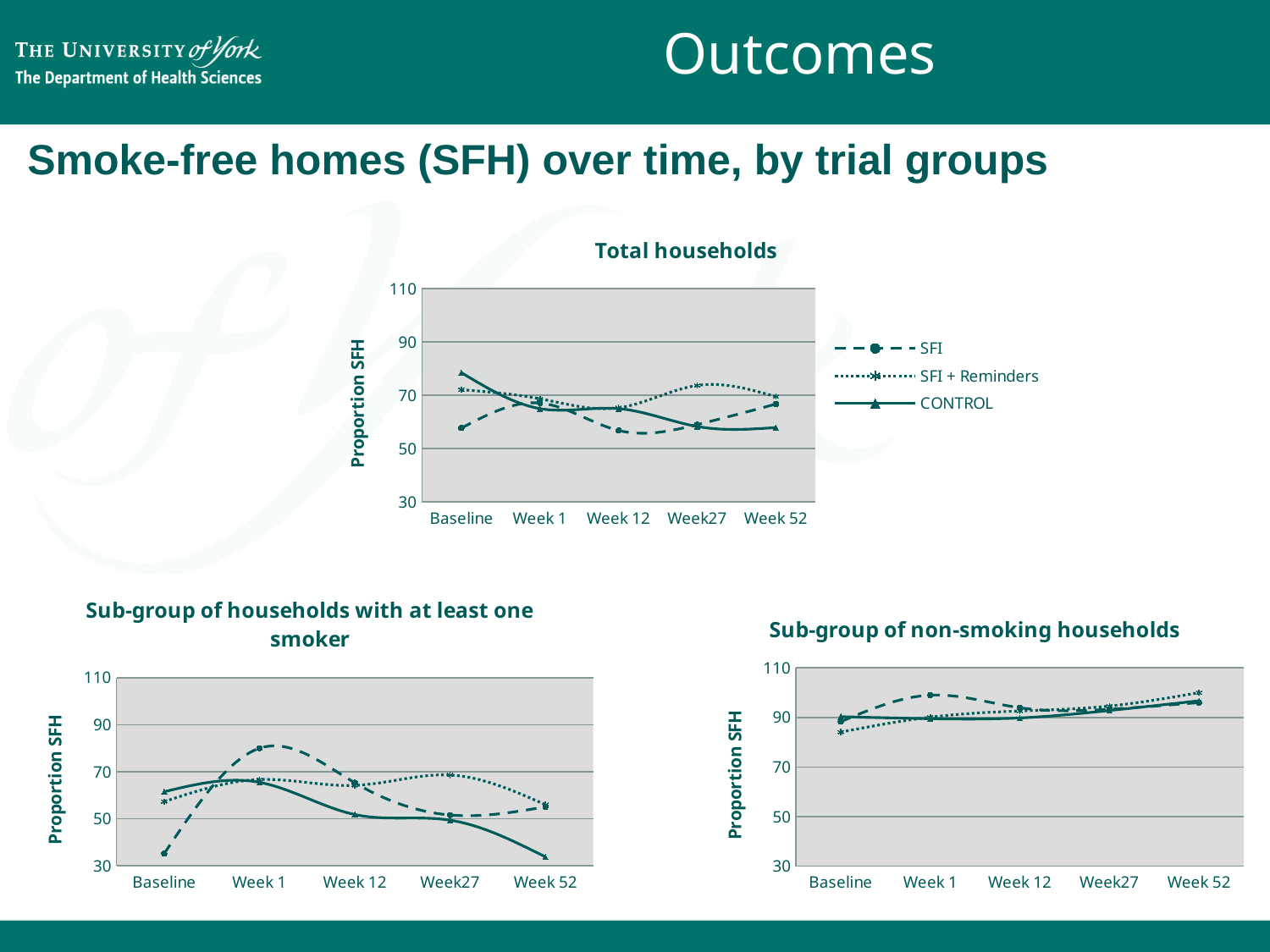
In the "Sub-group of households with at least one smoker" chart, at which time point is the SFI line highest? Week 1 What is the title of the chart at the bottom right of the slide? Sub-group of non-smoking households In the "Total households" chart, does the CONTROL line rise or fall from Baseline to Week 52? Fall What kind of chart is the "Total households" chart? Line chart In the "Total households" chart, is the CONTROL value at Baseline greater or less than 70? greater How many series does the legend on the slide list? 3 In the "Total households" chart, which is larger at Baseline, the SFI value or the CONTROL value? CONTROL In the "Sub-group of households with at least one smoker" chart, is the SFI value at Baseline greater or less than 50? less In the "Total households" chart, is the SFI value at Baseline greater or less than 70? less How many time points are shown on the x axis of the "Sub-group of non-smoking households" chart? 5 In the "Sub-group of households with at least one smoker" chart, which is larger at Week 52, the SFI + Reminders value or the CONTROL value? SFI + Reminders